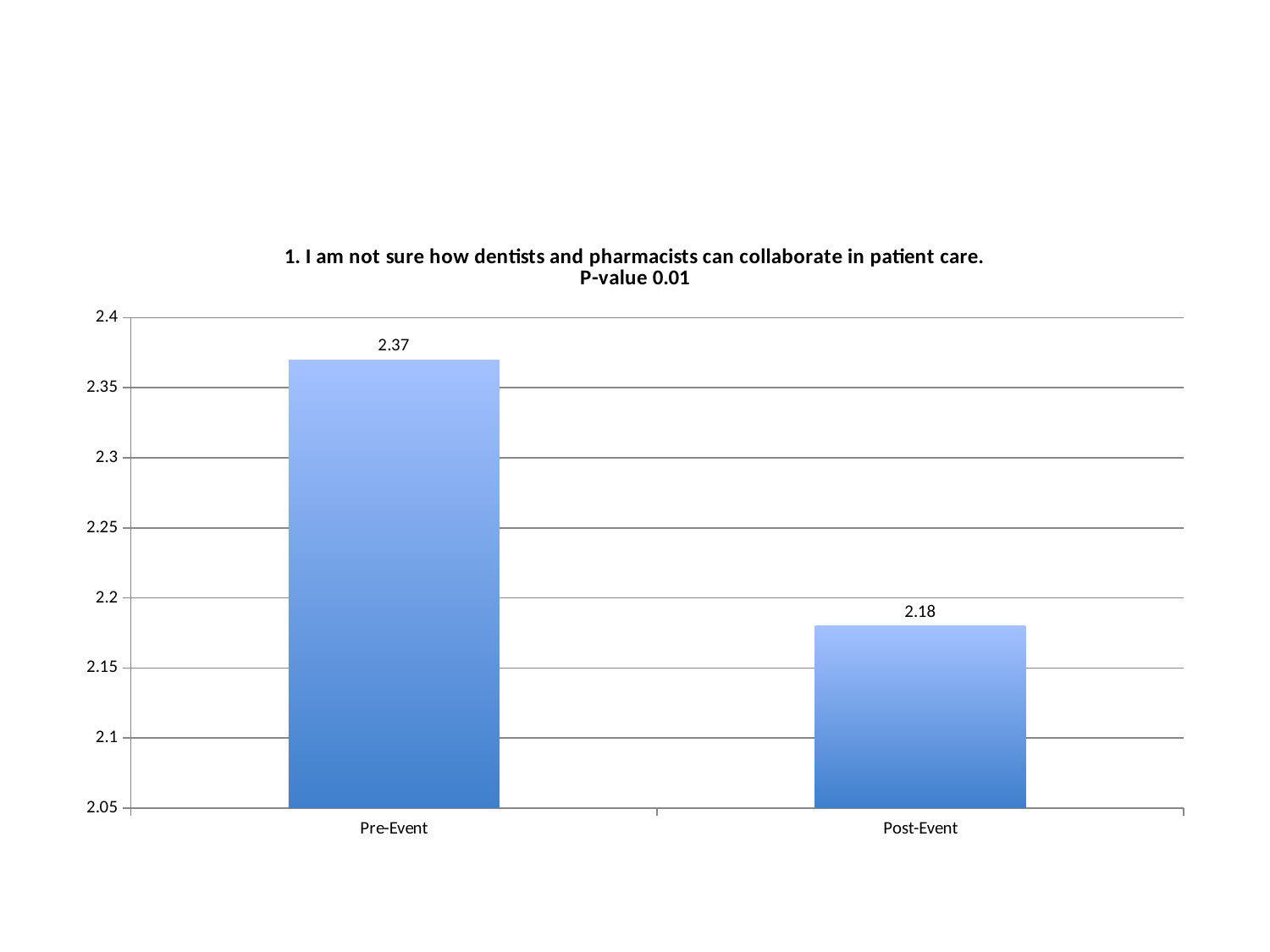
Which category has the highest value? Pre-Event Is the value for Post-Event greater or less than 2.2? less What kind of chart is shown on the slide? bar chart How many categories are shown on the x axis? 2 Which is larger, the Pre-Event value or the Post-Event value? Pre-Event What is the value for Post-Event? 2.18 Which category has the lowest value? Post-Event What is the value for Pre-Event? 2.37 What P-value is stated in the chart title? 0.01 What is the difference between the Pre-Event and Post-Event values? 0.19 Is the value for Pre-Event greater or less than 2.3? greater Do the values rise or fall from Pre-Event to Post-Event? fall